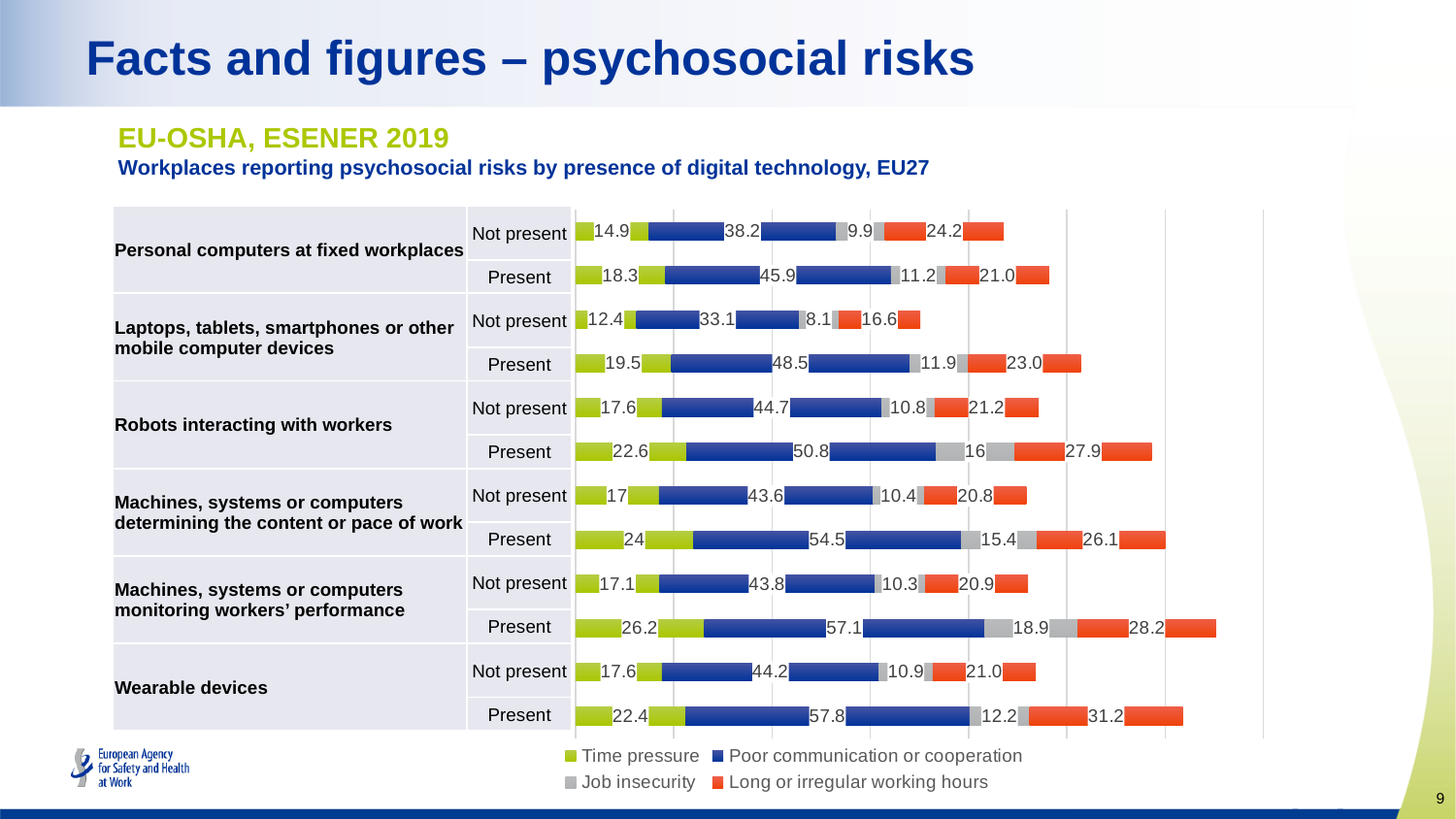
How many bars are plotted in the chart? 12 How many series does the legend list? 4 Which bar has the highest Time pressure value? Machines, systems or computers monitoring workers' performance, Present (26.2) What kind of chart is shown on the slide? Stacked bar chart What is the Poor communication or cooperation value for Laptops, tablets, smartphones or other mobile computer devices, Not present? 33.1 What is the difference in Poor communication or cooperation between Present and Not present for Wearable devices? 13.6 What is the Time pressure value for Wearable devices, Present? 22.4 Which bar has the lowest Poor communication or cooperation value? Laptops, tablets, smartphones or other mobile computer devices, Not present (33.1) What is the Job insecurity value for Machines, systems or computers monitoring workers' performance, Present? 18.9 What is the total of the stacked bar for Wearable devices, Present? 123.6 Which is larger: Long or irregular working hours for Personal computers at fixed workplaces Not present, or Present? Not present (24.2) What is the Long or irregular working hours value for Robots interacting with workers, Present? 27.9